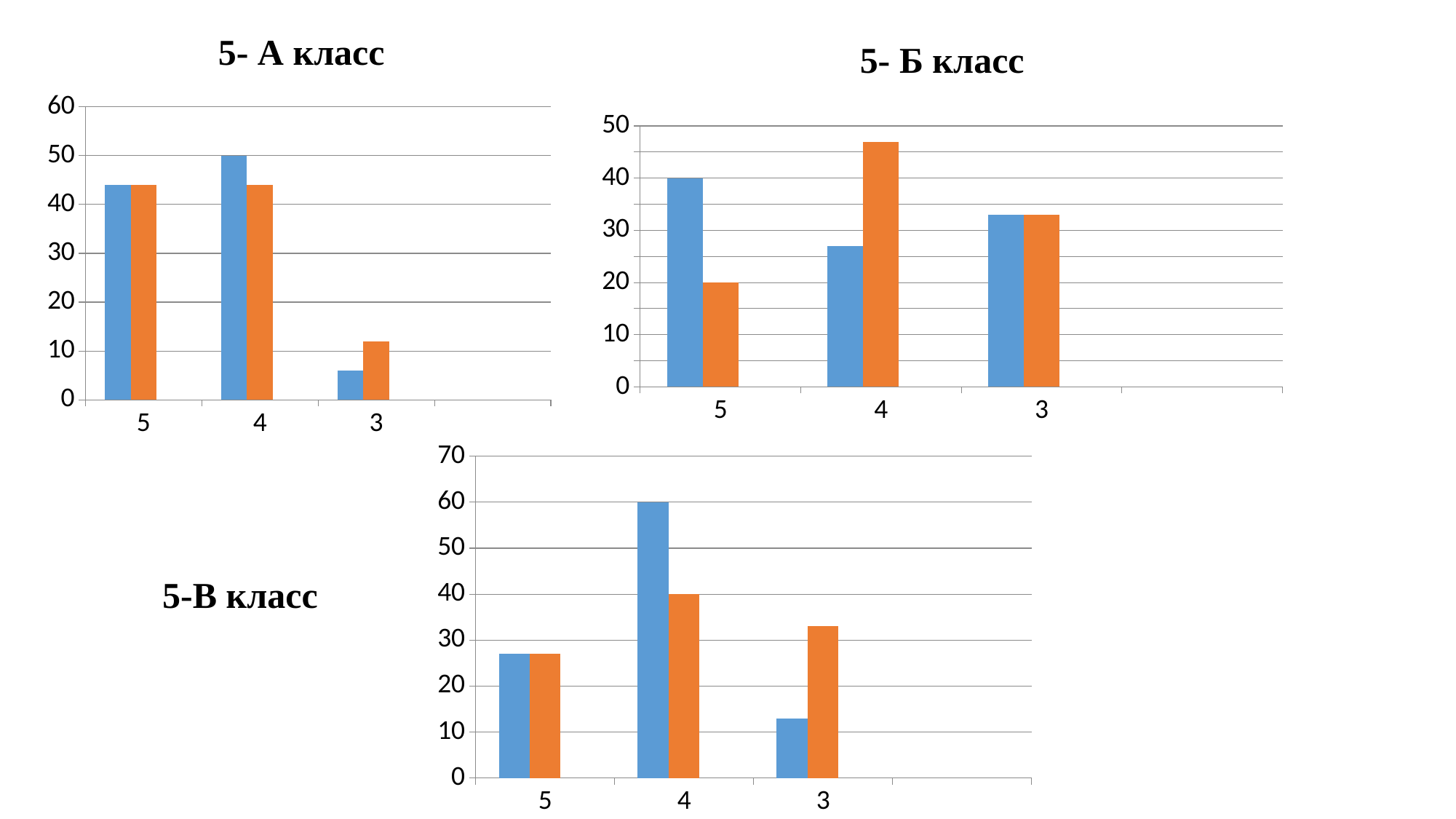
How many categories are shown on the x axis of the "5- Б класс" chart? 3 What kind of chart is the "5- А класс" chart? bar chart In the "5-В класс" chart, what is the value of the orange bar for category 4? 40 In the "5- А класс" chart, is the orange bar for category 3 greater or less than 20? less In the "5- А класс" chart, which category has the lowest blue bar? 3 In the "5- Б класс" chart, which category has the highest orange bar? 4 In the "5- Б класс" chart, what is the value of the orange bar for category 5? 20 In the "5- А класс" chart, what is the value of the blue bar for category 4? 50 In the "5-В класс" chart, what is the value of the blue bar for category 4? 60 In the "5- Б класс" chart, is the blue bar for category 4 larger or smaller than the orange bar for category 4? smaller In the "5-В класс" chart, is the blue bar for category 3 greater or less than 20? less In the "5- Б класс" chart, what is the value of the blue bar for category 5? 40